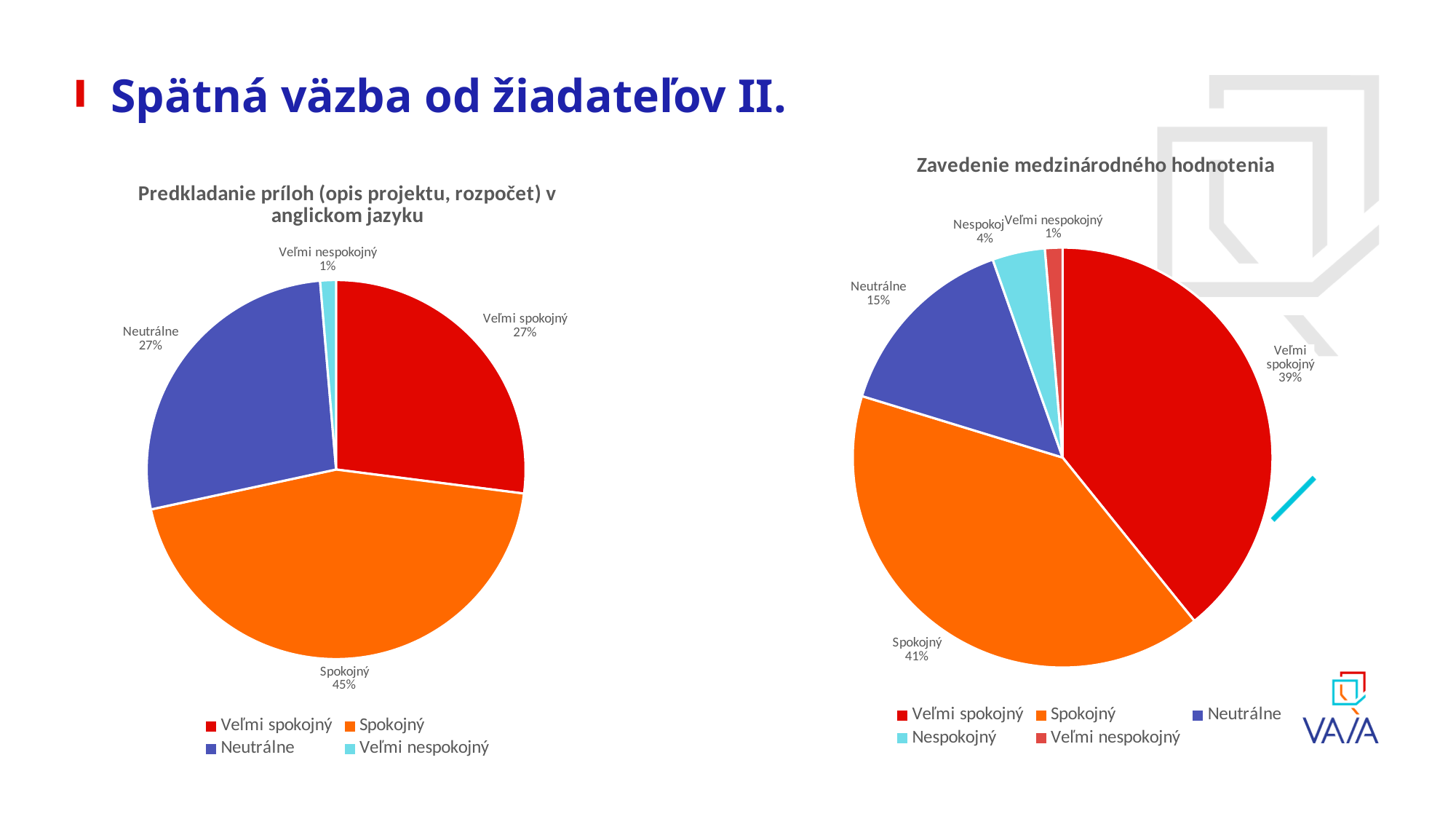
In the left chart 'Predkladanie príloh (opis projektu, rozpočet) v anglickom jazyku', which category has the largest slice? Spokojný In the left chart 'Predkladanie príloh (opis projektu, rozpočet) v anglickom jazyku', what share does 'Veľmi nespokojný' have? 1% In the left chart 'Predkladanie príloh (opis projektu, rozpočet) v anglickom jazyku', what is the difference between 'Spokojný' and 'Neutrálne'? 18% In the right chart 'Zavedenie medzinárodného hodnotenia', how many entries does the legend list? 5 What type of chart is the right chart 'Zavedenie medzinárodného hodnotenia'? Pie chart In the right chart 'Zavedenie medzinárodného hodnotenia', what share does 'Veľmi spokojný' have? 39% In the right chart 'Zavedenie medzinárodného hodnotenia', which colour represents 'Nespokojný'? Light blue In the right chart 'Zavedenie medzinárodného hodnotenia', which category has the smallest slice? Veľmi nespokojný In the right chart 'Zavedenie medzinárodného hodnotenia', what is the difference between 'Spokojný' and 'Veľmi spokojný'? 2% In the left chart 'Predkladanie príloh (opis projektu, rozpočet) v anglickom jazyku', how many slices does the pie have? 4 In the right chart 'Zavedenie medzinárodného hodnotenia', what share does 'Neutrálne' have? 15% In the left chart 'Predkladanie príloh (opis projektu, rozpočet) v anglickom jazyku', what share does 'Spokojný' have? 45%